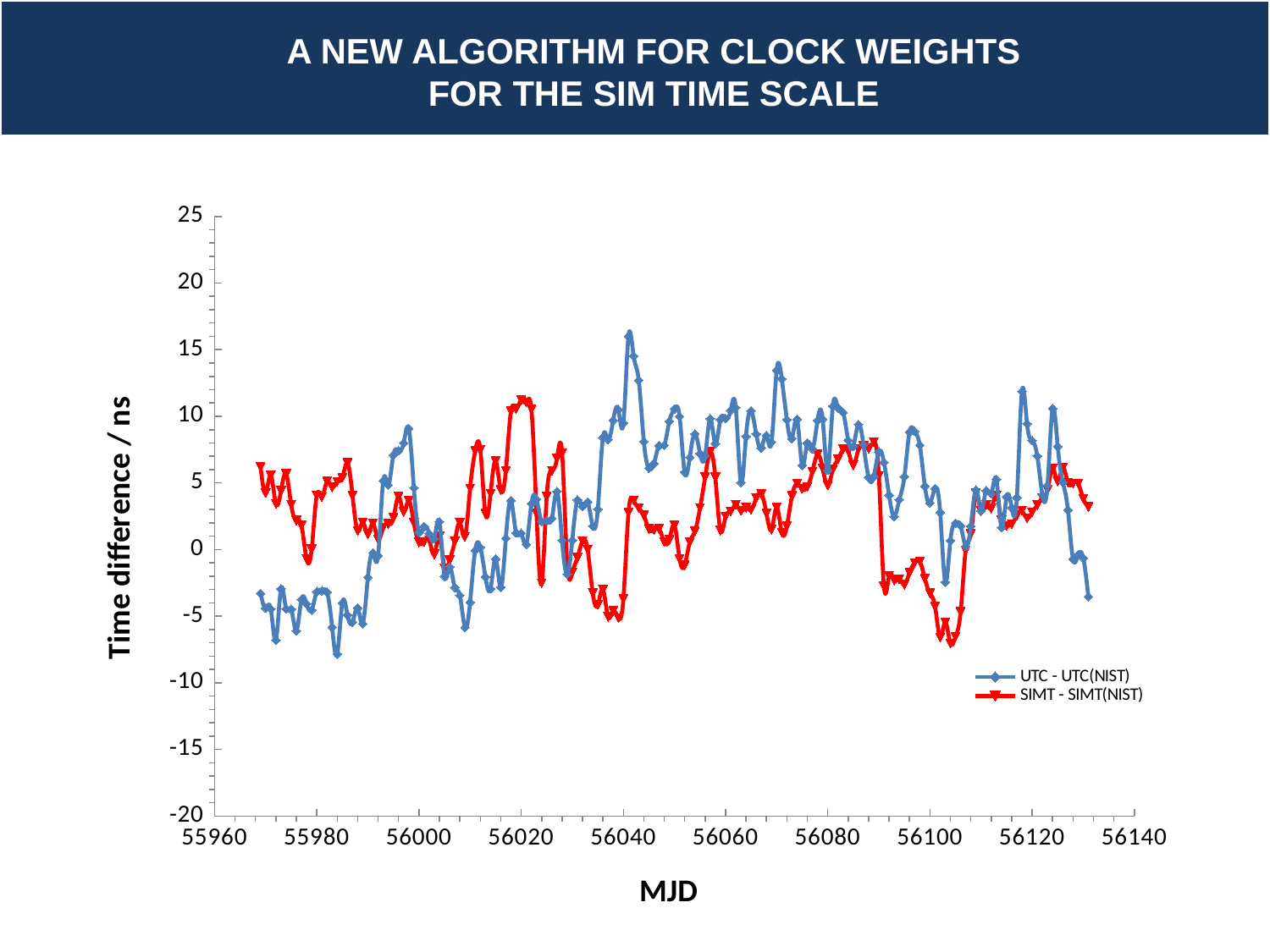
Around MJD 56060, which series has the higher value, UTC - UTC(NIST) or SIMT - SIMT(NIST)? UTC - UTC(NIST) What are the two series named in the legend? UTC - UTC(NIST) and SIMT - SIMT(NIST) What is the label of the y axis? Time difference / ns Which colour is used for the SIMT - SIMT(NIST) series? red Is the lowest value of the SIMT - SIMT(NIST) series greater or less than -5 ns? less Is the lowest value of the UTC - UTC(NIST) series greater or less than -5 ns? less What kind of chart is shown on the slide? line chart How many series does the legend list? 2 Around MJD 56100, which series has the lower value, UTC - UTC(NIST) or SIMT - SIMT(NIST)? SIMT - SIMT(NIST) Around MJD 55970, which series has the higher value, UTC - UTC(NIST) or SIMT - SIMT(NIST)? SIMT - SIMT(NIST) Is the highest value of the SIMT - SIMT(NIST) series greater or less than 5 ns? greater